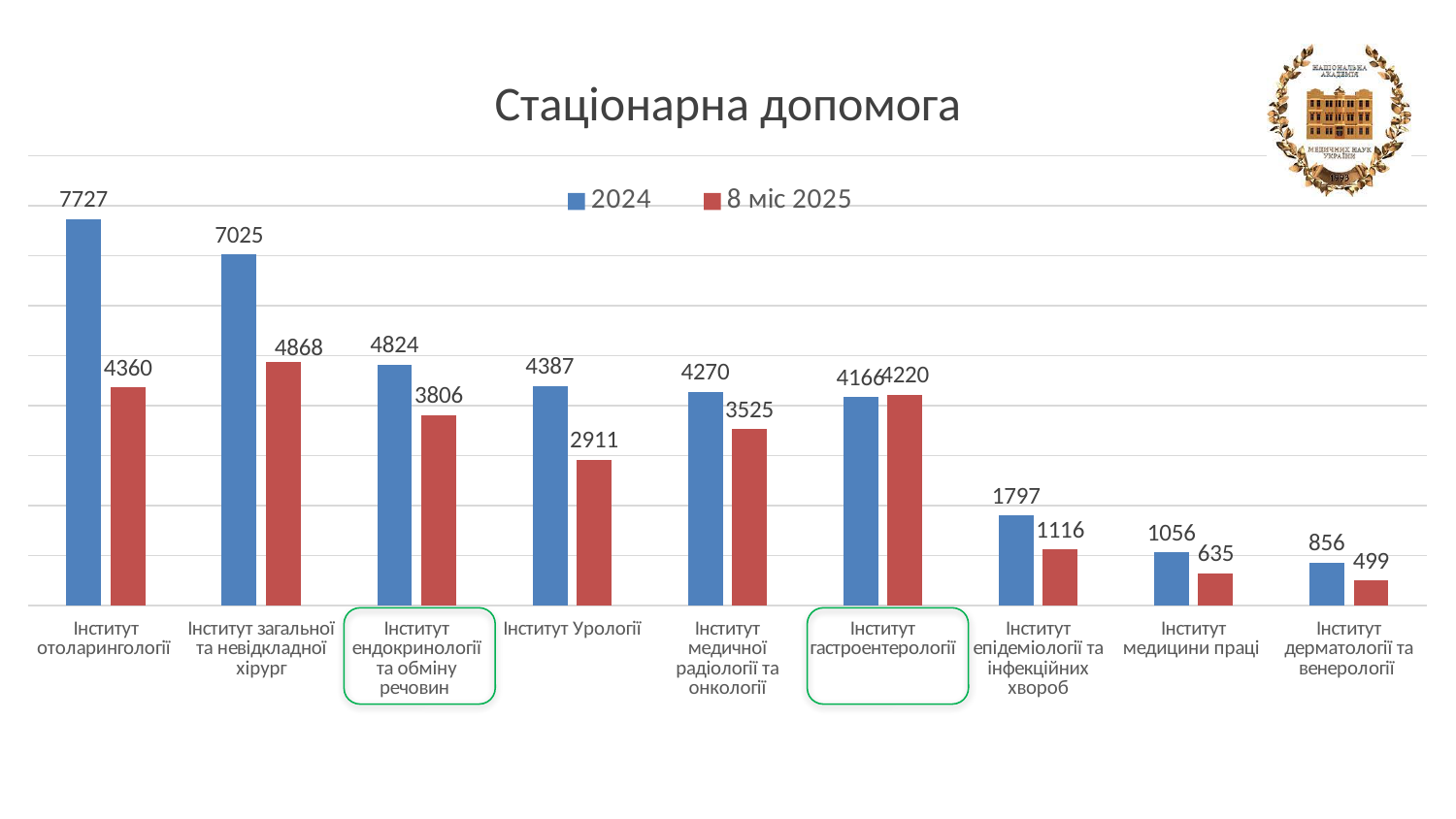
How many institutes are shown on the x axis? 9 Which has the larger 2024 value: Інститут загальної та невідкладної хірург or Інститут ендокринології та обміну речовин? Інститут загальної та невідкладної хірург What is the difference between the 2024 and 8 міс 2025 values for Інститут отоларингології? 3367 What is the difference between the 2024 and 8 міс 2025 values for Інститут медицини праці? 421 Which institute has the highest 2024 value? Інститут отоларингології What is the title of the chart? Стаціонарна допомога What is the 2024 value for Інститут отоларингології? 7727 What is the 8 міс 2025 value for Інститут епідеміології та інфекційних хвороб? 1116 How many series does the legend list? 2 Which institute has the lowest 8 міс 2025 value? Інститут дерматології та венерології What is the 8 міс 2025 value for Інститут Урології? 2911 What kind of chart is shown on the slide? Bar chart